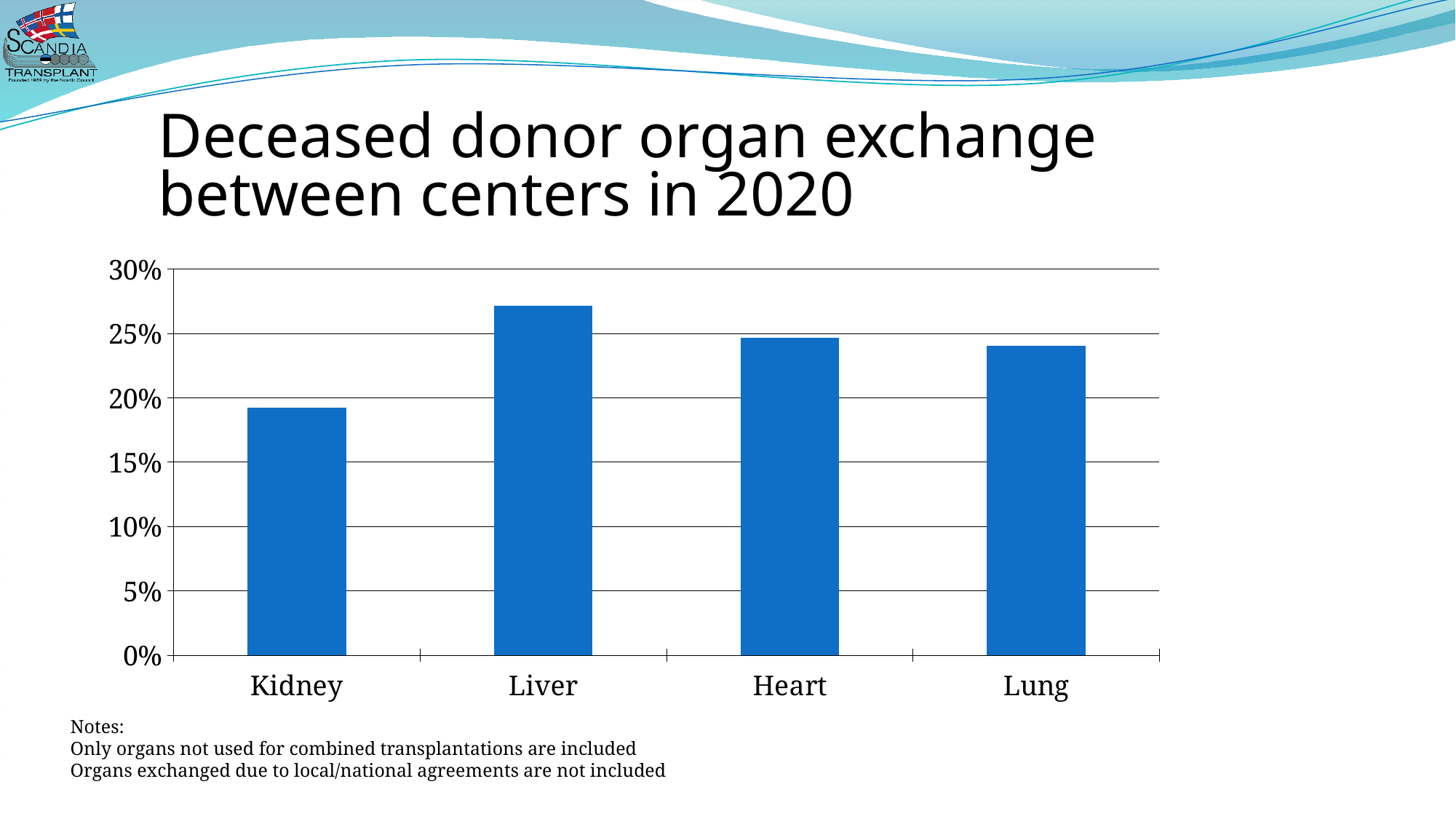
Which organ has the highest exchange percentage? Liver Is the value for Liver greater or less than 25%? greater What type of chart is shown on the slide? bar chart How many organ categories are shown in the chart? 4 Is the value for Lung greater or less than 25%? less Is the value for Heart greater or less than 20%? greater Which is larger, the value for Liver or the value for Kidney? Liver Which is larger, the value for Heart or the value for Kidney? Heart Which is larger, the value for Liver or the value for Lung? Liver What is the title of the chart on the slide? Deceased donor organ exchange between centers in 2020 Which organ has the lowest exchange percentage? Kidney